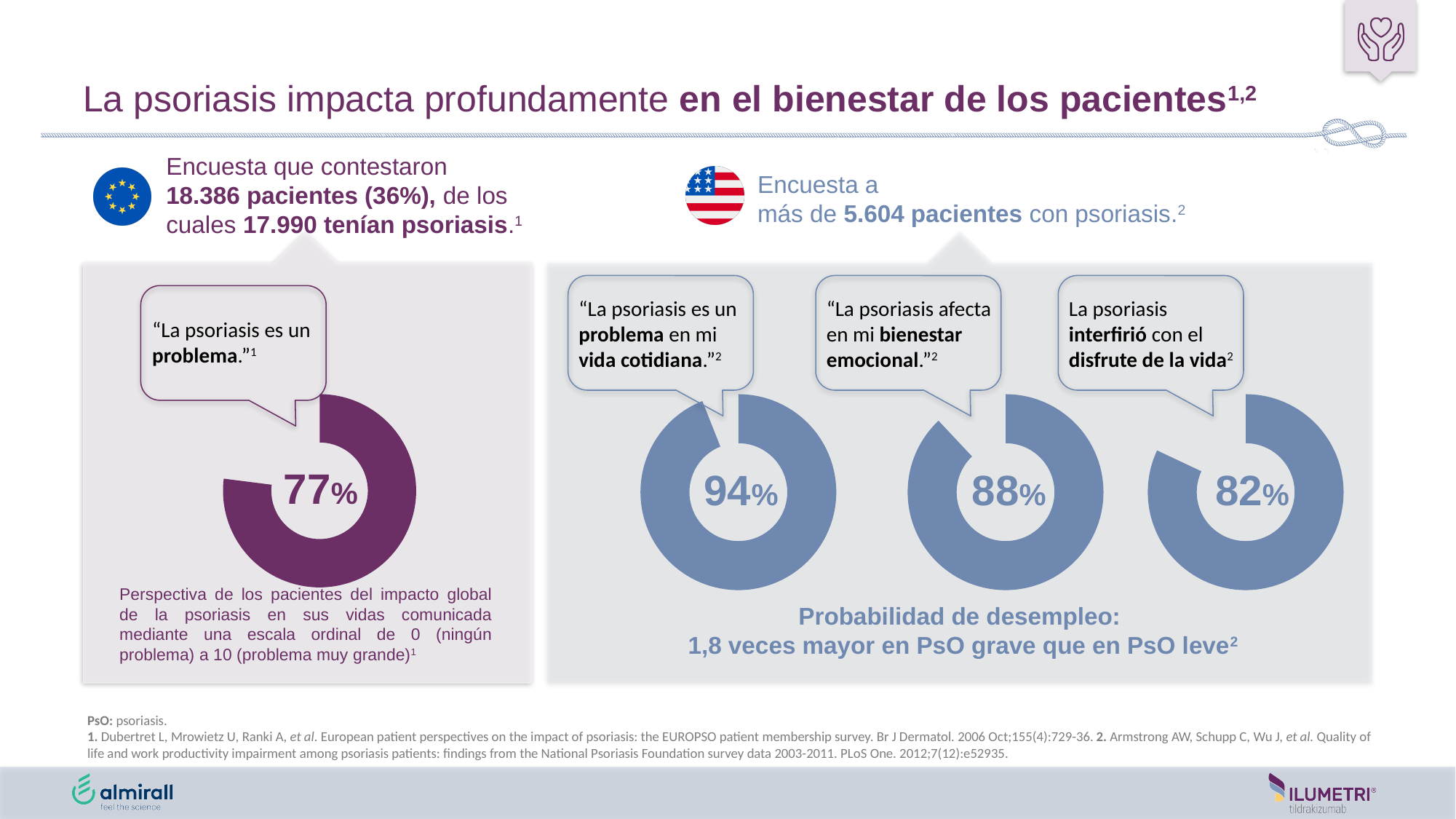
Which is larger: the percentage in the left purple donut chart or the percentage for "disfrute de la vida" in the right-hand panel? disfrute de la vida (82%) In the right-hand panel, what percentage is shown for "La psoriasis es un problema en mi vida cotidiana"? 94% Among the three blue donut charts in the right-hand panel, which statement has the lowest percentage? La psoriasis interfirió con el disfrute de la vida What is the difference between the 94% donut and the 82% donut in the right-hand panel? 12% What is the difference between the percentage for "problema en mi vida cotidiana" (94%) and "bienestar emocional" (88%) in the right-hand panel? 6% What type of chart is used to display the percentages on this slide? Donut (pie) chart How many donut charts are shown on the slide in total? 4 What percentage is shown in the purple donut chart on the left ("La psoriasis es un problema")? 77% In the right-hand panel, what percentage is shown for "La psoriasis interfirió con el disfrute de la vida"? 82% In the right-hand panel, what percentage is shown for "La psoriasis afecta en mi bienestar emocional"? 88% What colour is the donut chart in the left panel? Purple Among the three blue donut charts in the right-hand panel, which statement has the highest percentage? La psoriasis es un problema en mi vida cotidiana